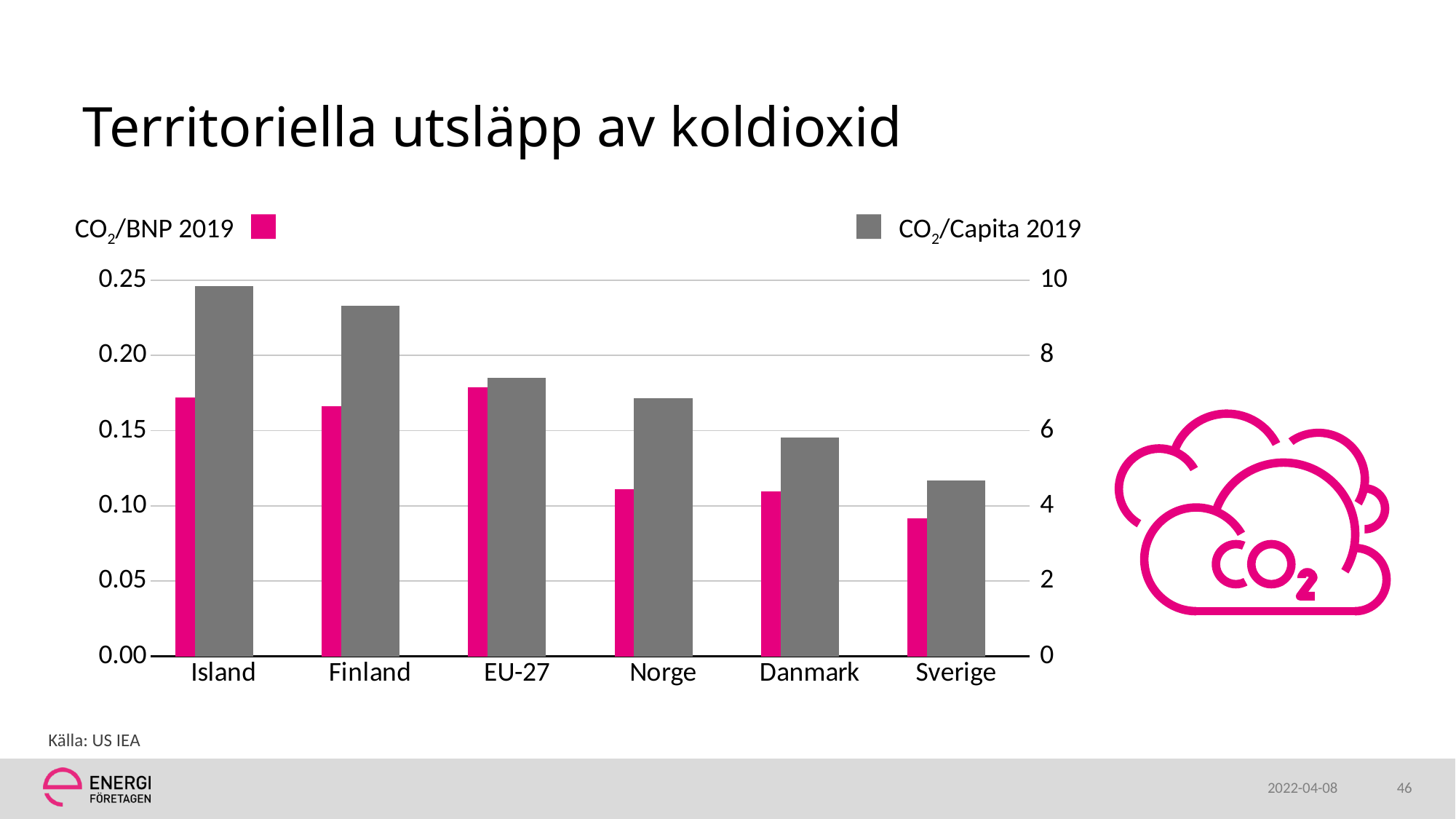
Is the CO2/Capita 2019 value for Norge greater or less than 8? less Is the CO2/Capita 2019 value for Island greater or less than 8? greater How many series does the chart's legend list? 2 What kind of chart is shown on the slide? Bar chart Which category has the highest CO2/Capita 2019 value? Island How many countries or regions are shown on the x axis of the chart? 6 Do the CO2/Capita 2019 values generally rise or fall from Island to Sverige along the x axis? Fall Which category has the lowest CO2/BNP 2019 value? Sverige Is the CO2/BNP 2019 value for Island greater or less than 0.15? greater Which has the larger CO2/Capita 2019 value, Finland or EU-27? Finland Which category has the lowest CO2/Capita 2019 value? Sverige